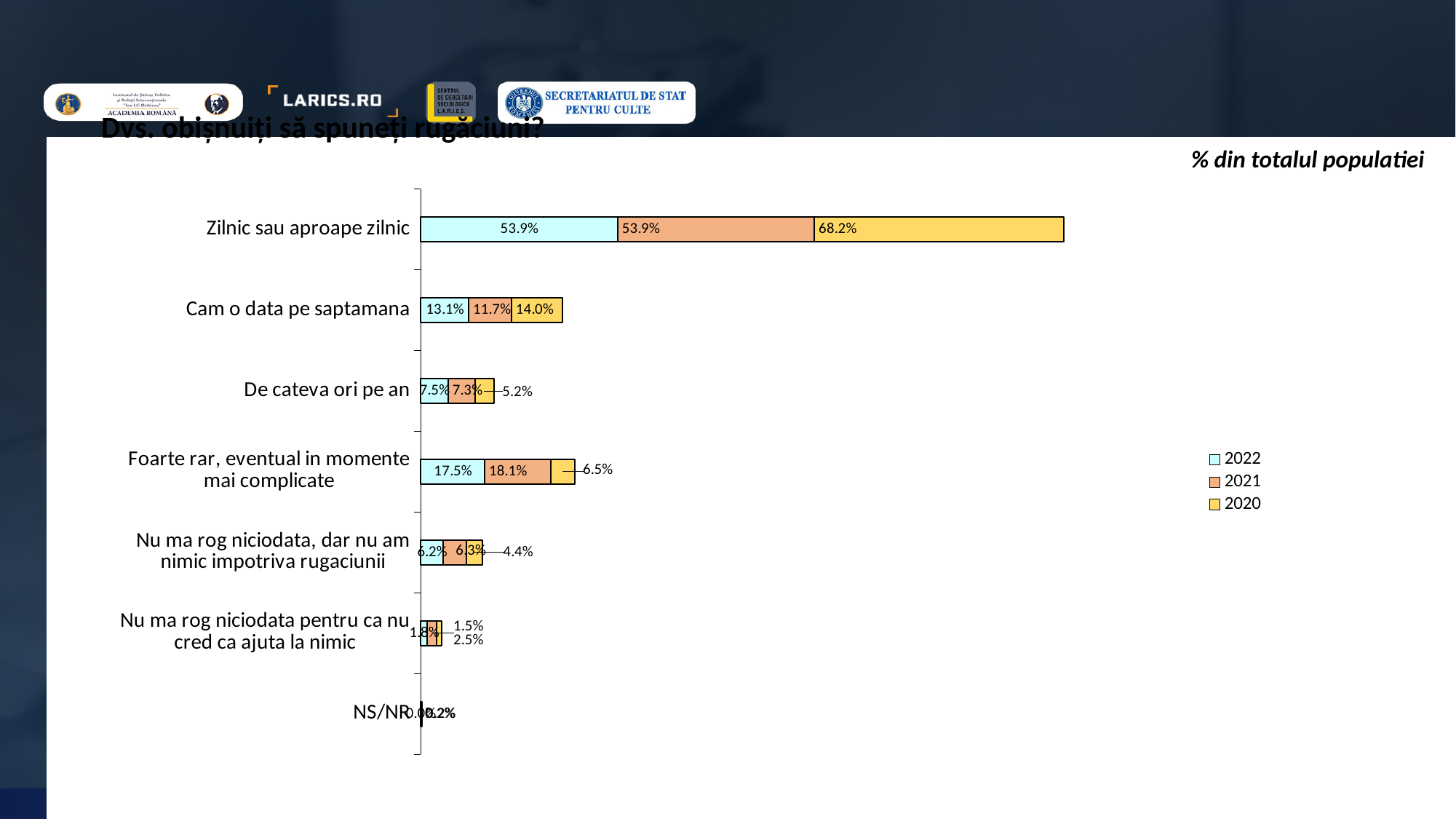
What is the 2021 value for "Foarte rar, eventual in momente mai complicate"? 18.1% What is the 2020 value for "De cateva ori pe an"? 5.2% Which is larger for "Foarte rar, eventual in momente mai complicate": the 2022 value or the 2020 value? 2022 What type of chart is shown on the slide? Stacked bar chart What is the 2020 value for "Zilnic sau aproape zilnic"? 68.2% What is the difference between the 2020 and 2022 values for "Zilnic sau aproape zilnic"? 14.3% What is the total of the stacked bar for "Cam o data pe saptamana"? 38.8% What is the 2022 value for "Cam o data pe saptamana"? 13.1% How many series does the legend list? 3 Which legend entry is shown in yellow? 2020 How many categories are shown on the chart? 7 Which category has the highest 2022 value? Zilnic sau aproape zilnic